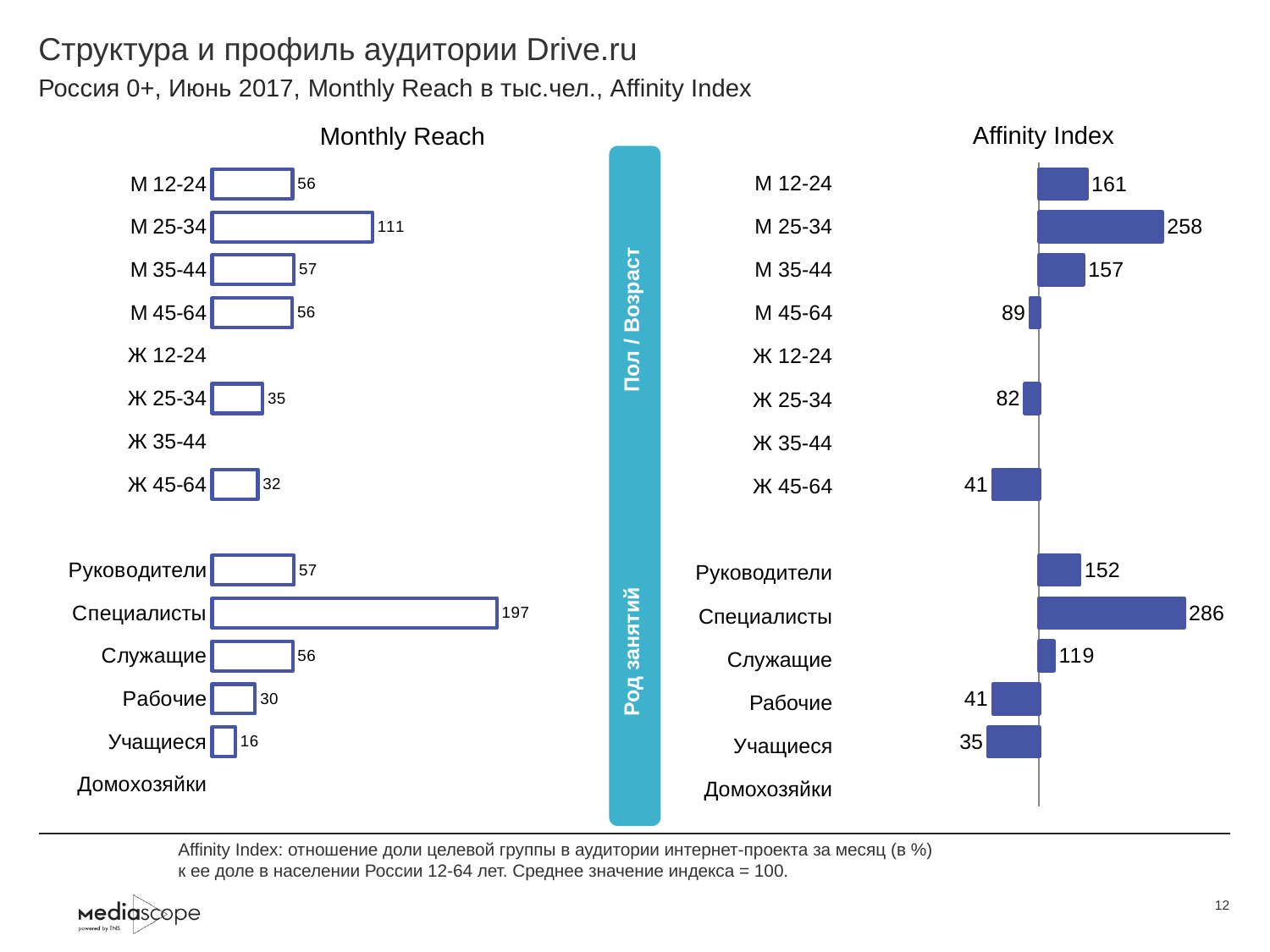
In the Monthly Reach chart, which is larger: the value for Ж 25-34 or the value for Ж 45-64? Ж 25-34 What kind of chart is the Affinity Index chart? Bar chart In the Affinity Index chart, what is the difference between the values for Специалисты and Руководители? 134 In the Monthly Reach chart, what is the value for М 25-34? 111 In the Affinity Index chart, what is the value for Служащие? 119 In the Monthly Reach chart, what is the value for Специалисты? 197 In the Monthly Reach chart, what is the difference between the values for М 25-34 and М 12-24? 55 In the Affinity Index chart, which category has the highest value? Специалисты In the Affinity Index chart, which is larger: the value for М 12-24 or the value for М 35-44? М 12-24 In the Affinity Index chart, what is the value for Учащиеся? 35 In the Monthly Reach chart, which labelled category has the lowest value? Учащиеся In the Affinity Index chart, what is the value for М 25-34? 258